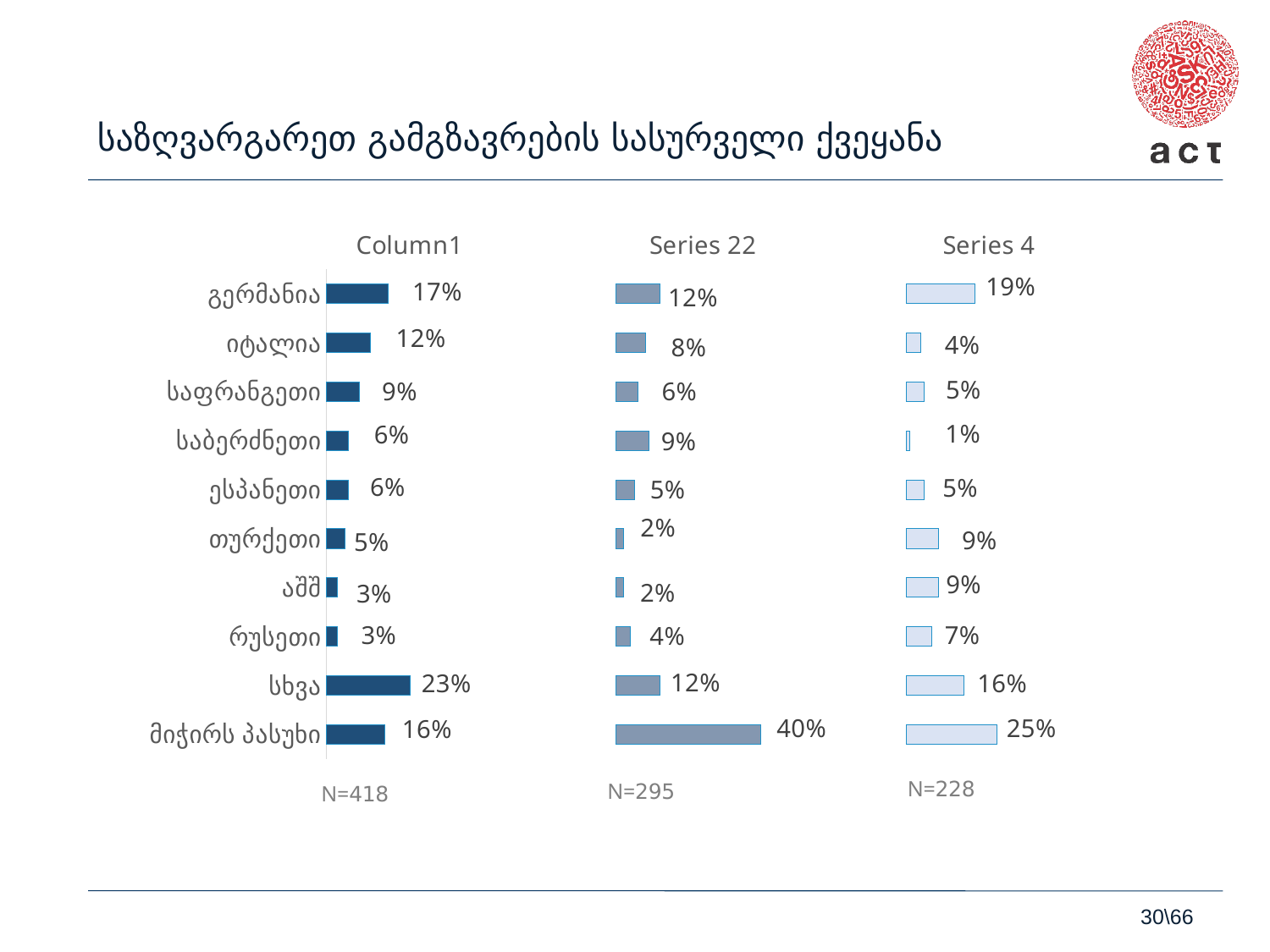
What sample size (N) is shown under the chart titled Series 22? N=295 In the chart titled Series 22, which category has the highest value? მიჭირს პასუხი In the chart titled Series 22, what is the difference between the values for მიჭირს პასუხი and სხვა? 28% How many categories are shown in the chart titled Column1? 10 In the chart titled Column1, what is the value for გერმანია? 17% What kind of chart is the chart titled Series 4? bar chart In the chart titled Series 4, which category has the lowest value? საბერძნეთი In the chart titled Series 4, which is larger, the value for გერმანია or the value for სხვა? გერმანია In the chart titled Series 4, what is the value for საბერძნეთი? 1% In the chart titled Column1, which category has the highest value? სხვა In the chart titled Column1, what is the difference between the values for სხვა and გერმანია? 6% In the chart titled Series 22, what is the value for მიჭირს პასუხი? 40%